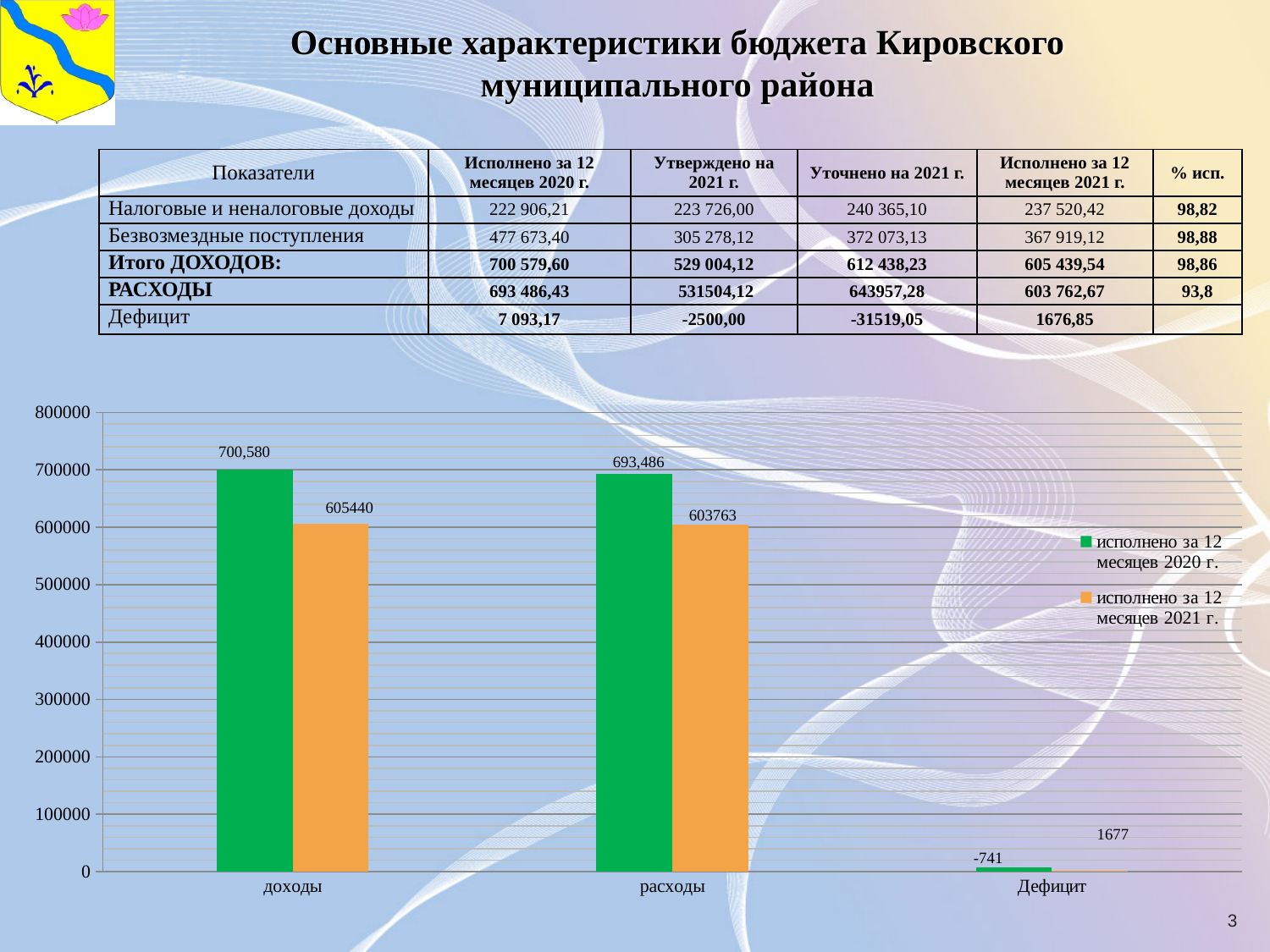
What is the value for Дефицит in the series исполнено за 12 месяцев 2021 г.? 1677 What is the value for расходы in the series исполнено за 12 месяцев 2020 г.? 693,486 Which category has the lowest value in the series исполнено за 12 месяцев 2021 г.? Дефицит What kind of chart is shown on the slide? bar chart What is the value for расходы in the series исполнено за 12 месяцев 2021 г.? 603763 What is the value for Дефицит in the series исполнено за 12 месяцев 2020 г.? -741 What is the value for доходы in the series исполнено за 12 месяцев 2020 г.? 700,580 Which is larger for расходы: the value for исполнено за 12 месяцев 2020 г. or for исполнено за 12 месяцев 2021 г.? исполнено за 12 месяцев 2020 г. What is the value for доходы in the series исполнено за 12 месяцев 2021 г.? 605440 How many categories are shown on the x axis of the chart? 3 How many series does the chart legend list? 2 Which colour represents the series исполнено за 12 месяцев 2021 г. in the chart? orange